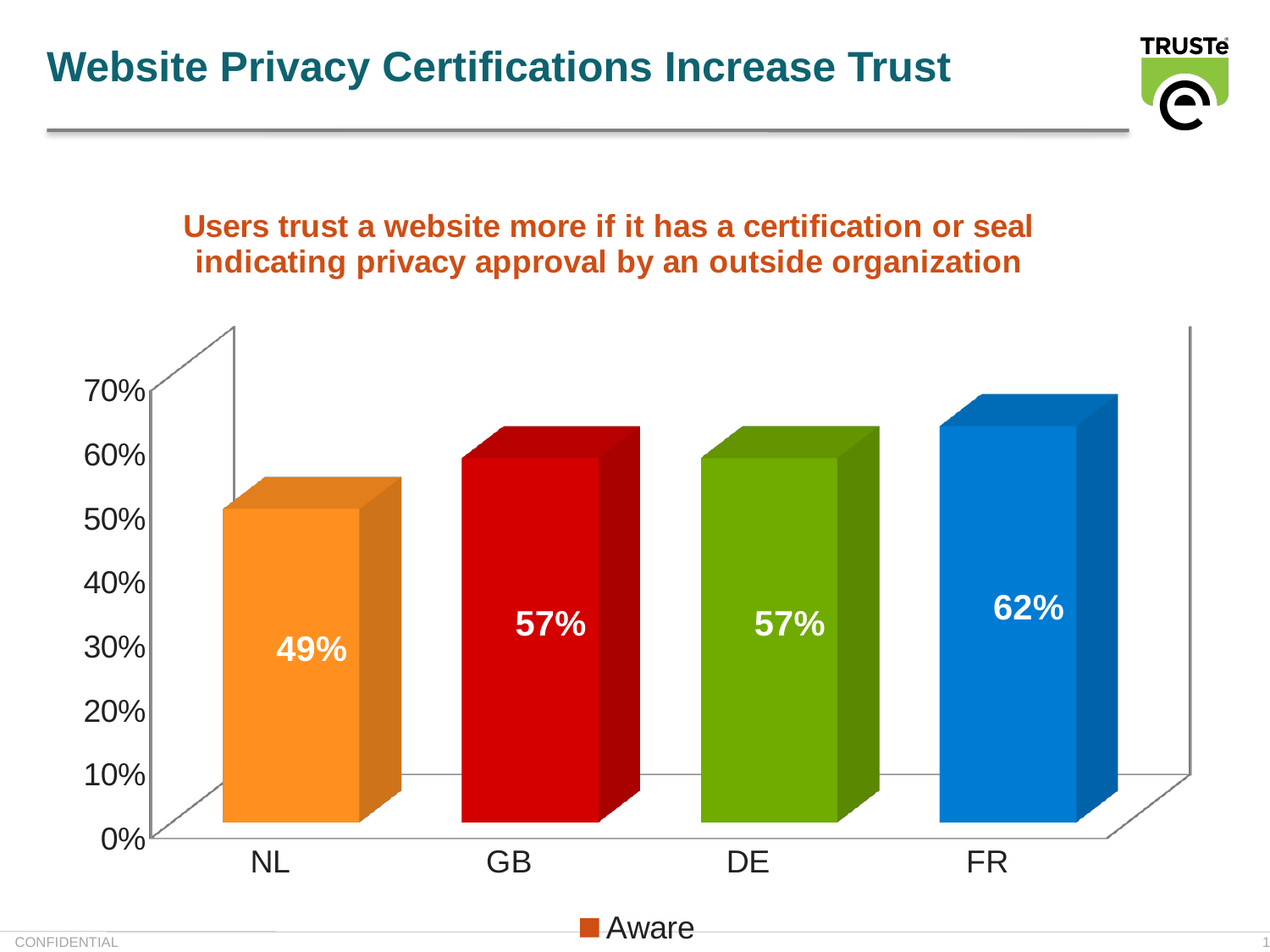
What is the value for FR? 62% What is the value for NL? 49% What kind of chart is shown? Bar chart Which country has the highest value? FR What is the difference between the values for GB and NL? 8% How many series does the legend list? 1 How many countries are shown on the x axis? 4 What is the difference between the values for FR and NL? 13% What is the value for GB? 57% Which country has the lowest value? NL Which is larger, the value for FR or the value for DE? FR What is the name of the series in the legend? Aware